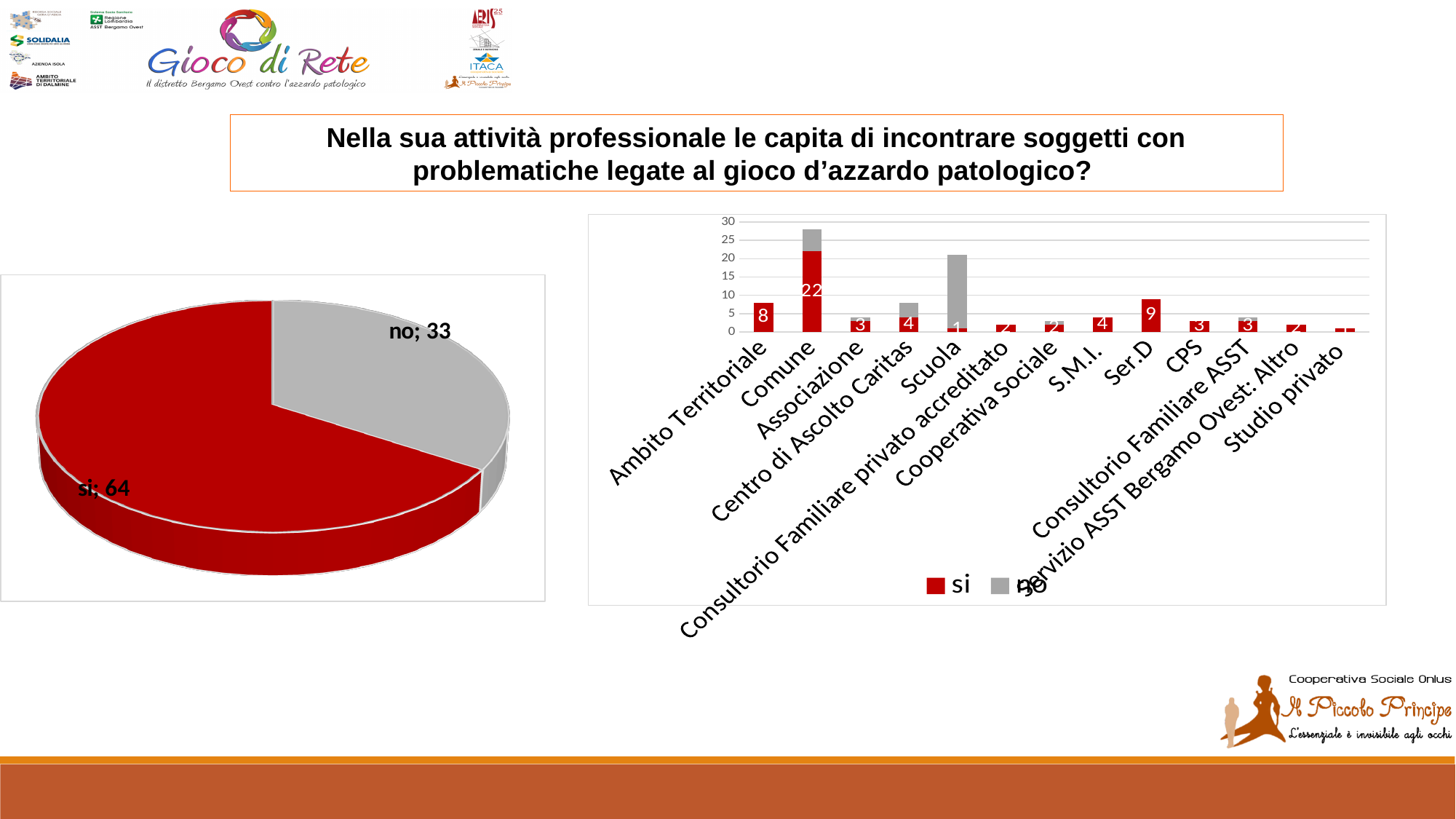
How many series does the legend of the bar chart on the right list? 2 In the bar chart on the right, what is the "si" value for Ambito Territoriale? 8 In the bar chart on the right, what is the "si" value for Comune? 22 In the pie chart on the left, what is the value for "no"? 33 What kind of chart is the chart on the left of the slide? Pie chart In the bar chart on the right, which category has the highest "si" value? Comune In the pie chart on the left, what is the value for "si"? 64 How many categories are shown on the x axis of the bar chart on the right? 13 In the bar chart on the right, what is the "si" value for Ser.D? 9 In the bar chart on the right, is the total stacked value for Comune greater or less than 25? greater In the pie chart on the left, what is the difference between the "si" and "no" values? 31 In the pie chart on the left, which slice is larger, "si" or "no"? si